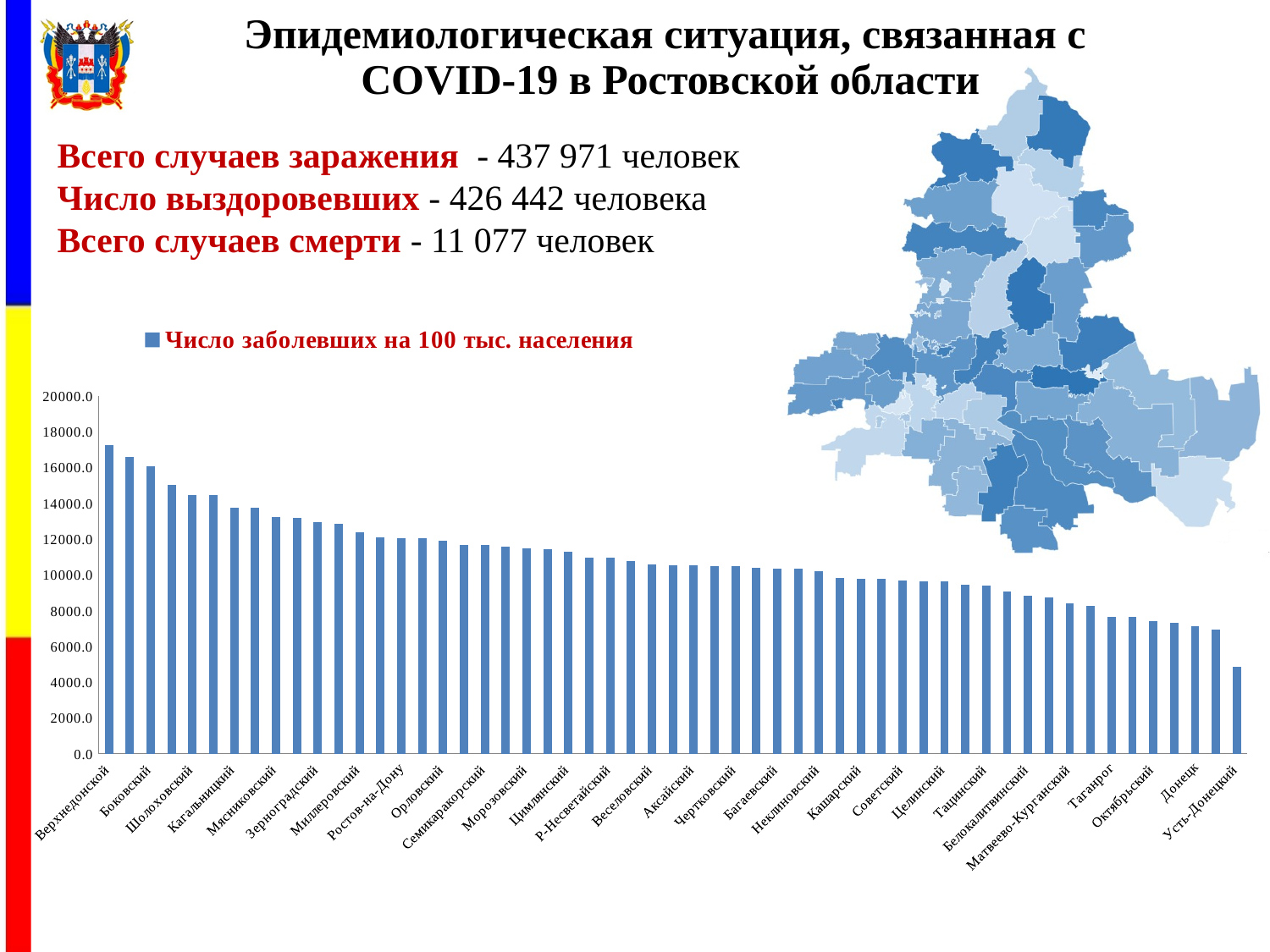
Which category has the lowest value in the chart? Усть-Донецкий What is the series name shown in the chart legend? Число заболевших на 100 тыс. населения Which has the larger value, Донецк or Ростов-на-Дону? Ростов-на-Дону Is the value for Ростов-на-Дону greater or less than 10000? greater Do the values rise or fall from left to right along the x axis? fall Is the value for Таганрог greater or less than 10000? less What kind of chart is shown on the slide? bar chart Is the value for Верхнедонской greater or less than 16000? greater Which category has the highest value in the chart? Верхнедонской Which has the larger value, Боковский or Таганрог? Боковский How many series does the chart legend list? 1